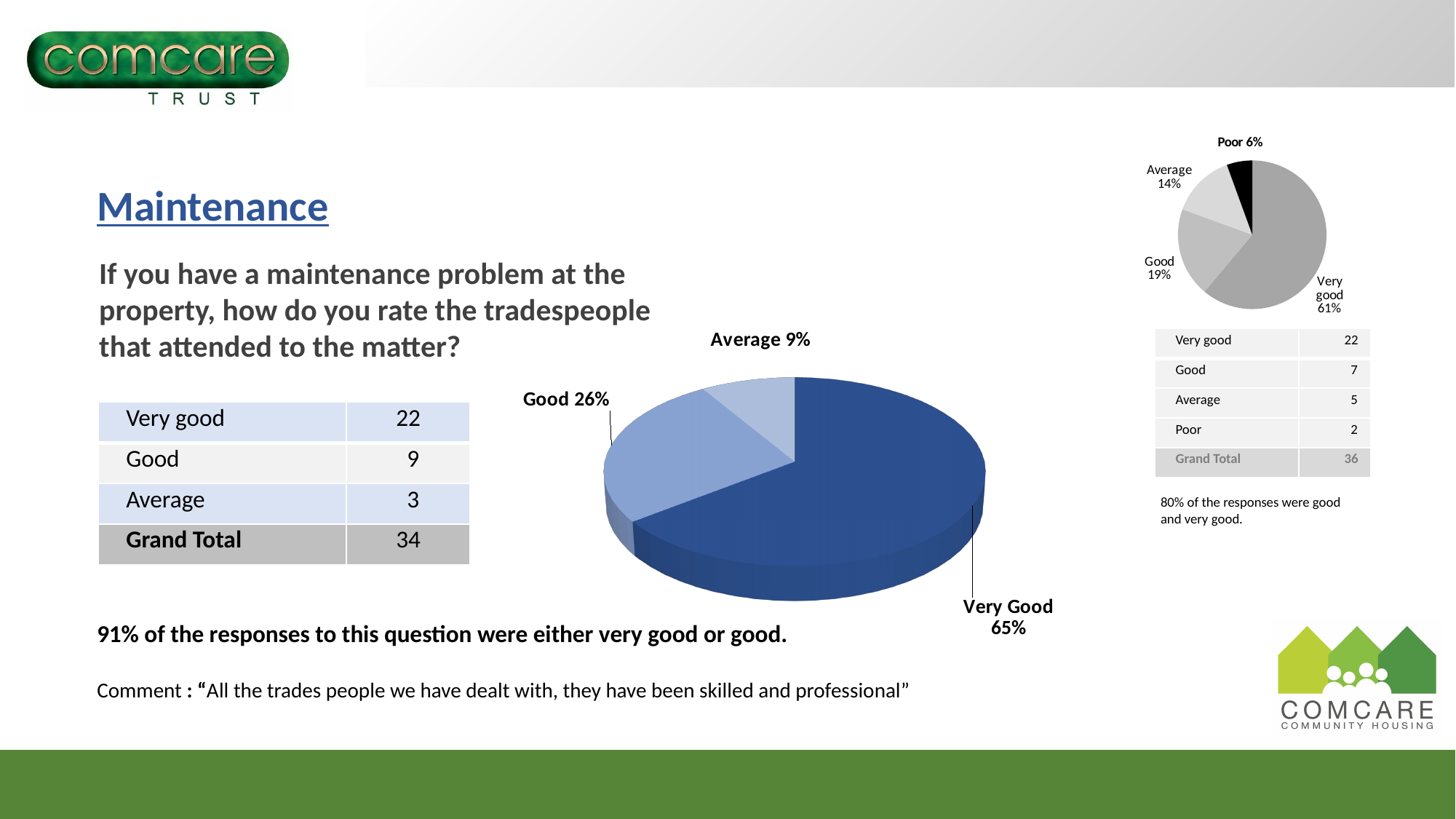
In the large blue pie chart in the centre, what share is labelled for Average? 9% How many slices does the small grey pie chart at the top right have? 4 In the small grey pie chart at the top right, what share is labelled for Poor? 6% In the small grey pie chart at the top right, which is larger, Good or Average? Good In the large blue pie chart in the centre, what share is labelled for Very Good? 65% In the large blue pie chart in the centre, which category has the smallest slice? Average How many slices does the large blue pie chart in the centre have? 3 In the large blue pie chart in the centre, which category has the largest slice? Very Good What kind of chart is the large blue chart in the centre of the slide? pie chart In the large blue pie chart in the centre, what is the difference in percentage points between Very Good and Good? 39